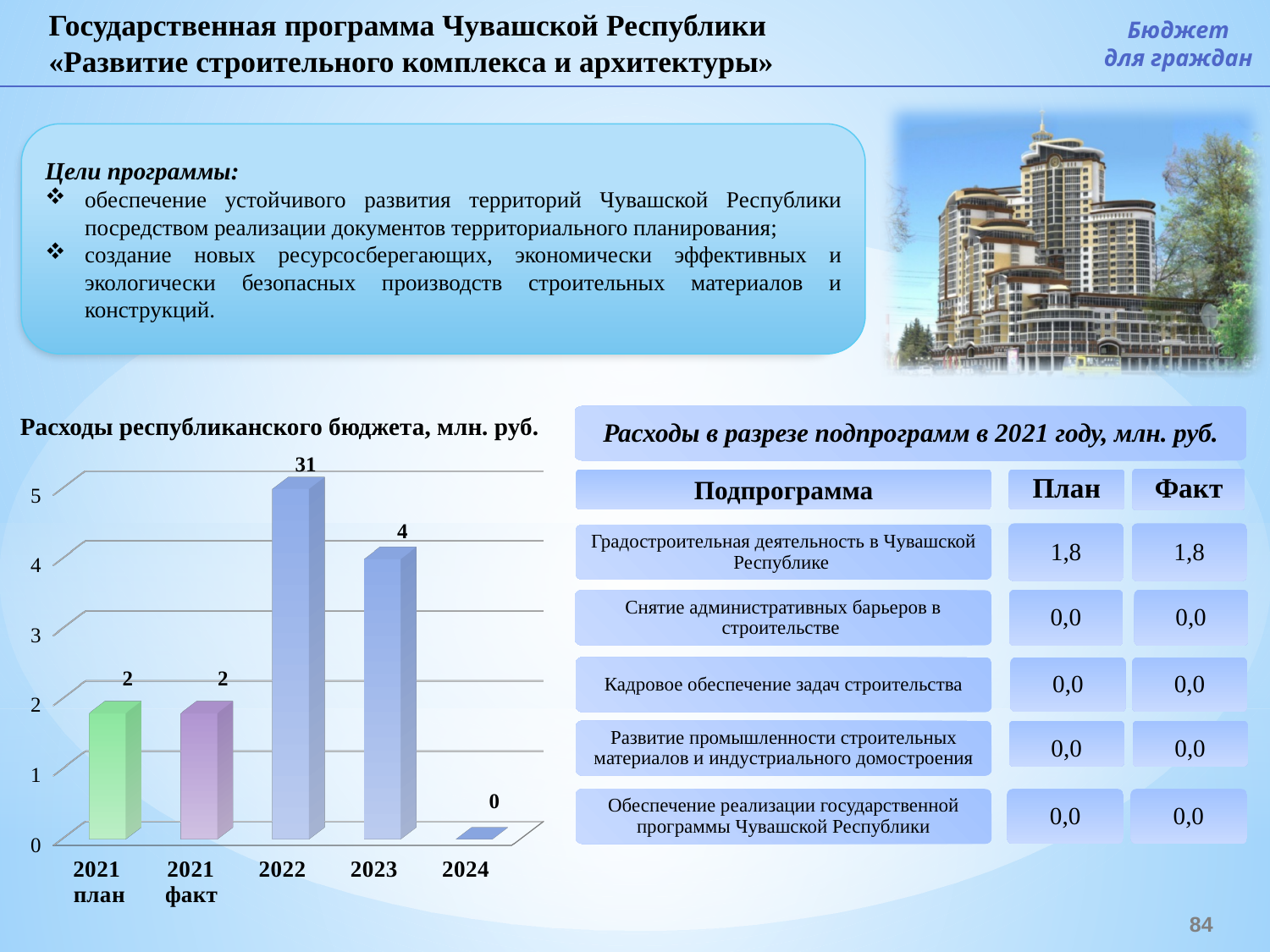
In the chart 'Расходы республиканского бюджета, млн. руб.', which category has the highest value? 2022 In the chart 'Расходы республиканского бюджета, млн. руб.', what is the value for 2024? 0 In the chart 'Расходы республиканского бюджета, млн. руб.', what is the value for 2022? 31 In the chart 'Расходы республиканского бюджета, млн. руб.', what is the value for 2021 план? 2 In the chart 'Расходы республиканского бюджета, млн. руб.', which category has the lowest value? 2024 In the chart 'Расходы республиканского бюджета, млн. руб.', what is the difference between the values for 2022 and 2023? 27 In the chart 'Расходы республиканского бюджета, млн. руб.', which is larger, the value for 2023 or the value for 2024? 2023 In the chart 'Расходы республиканского бюджета, млн. руб.', what is the difference between the values for 2023 and 2021 факт? 2 How many categories are shown on the x axis of the chart 'Расходы республиканского бюджета, млн. руб.'? 5 What is the title of the chart on the lower left of the slide? Расходы республиканского бюджета, млн. руб. What kind of chart is 'Расходы республиканского бюджета, млн. руб.'? bar chart In the chart 'Расходы республиканского бюджета, млн. руб.', what is the value for 2023? 4